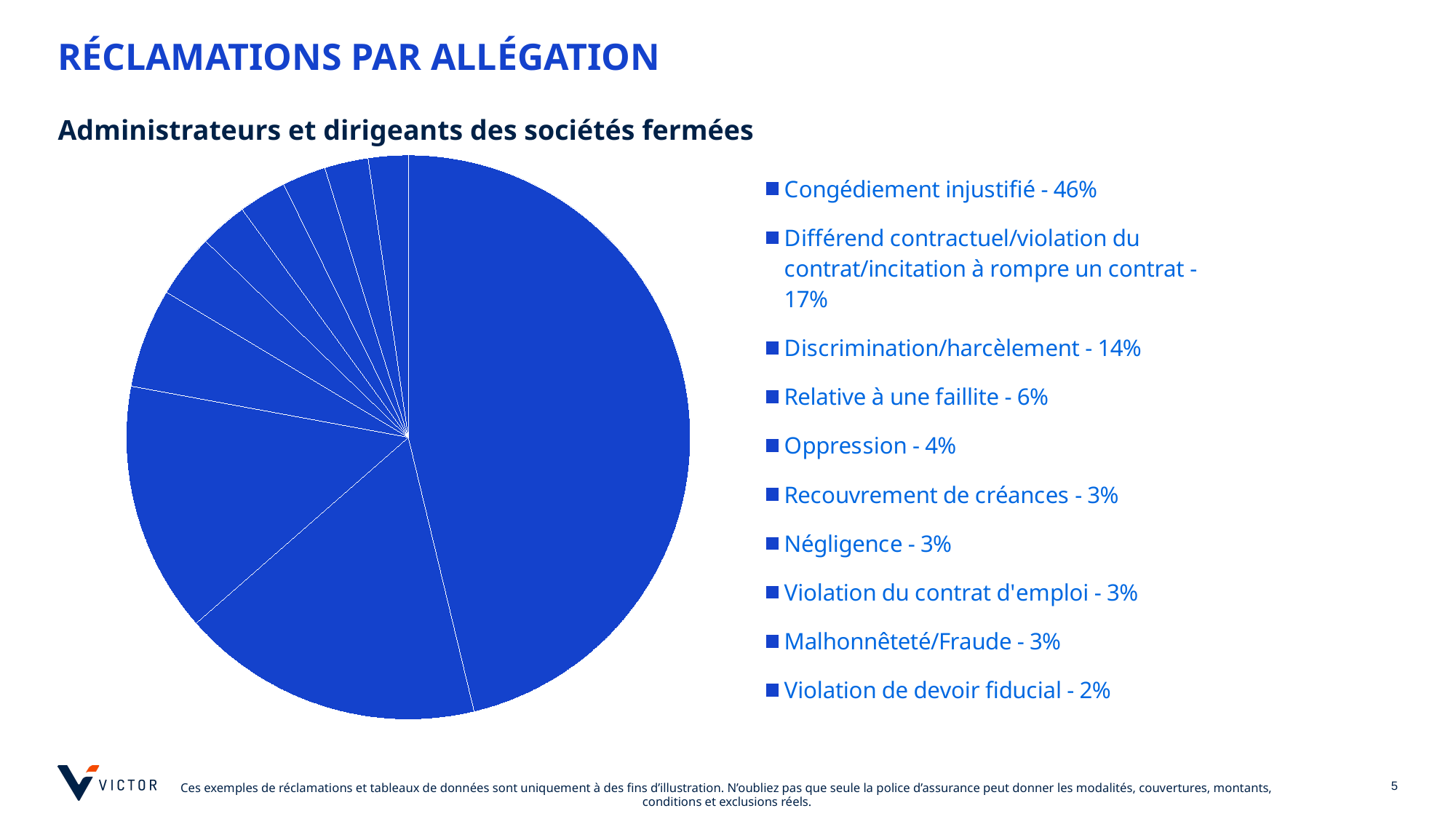
What is the combined share of Oppression and Recouvrement de créances? 7% Which has a larger share: Discrimination/harcèlement or Relative à une faillite? Discrimination/harcèlement Which allegation category has the largest share of the pie? Congédiement injustifié How many allegation categories are listed in the legend? 10 What share of claims is attributed to Congédiement injustifié? 46% What is the subtitle shown above the pie chart? Administrateurs et dirigeants des sociétés fermées What percentage is shown for Oppression? 4% What is the difference in percentage points between Congédiement injustifié and Différend contractuel/violation du contrat/incitation à rompre un contrat? 29 What kind of chart is shown on the slide? pie chart What percentage is shown for Relative à une faillite? 6% What percentage is shown for Discrimination/harcèlement? 14% Which allegation category has the smallest share of the pie? Violation de devoir fiducial